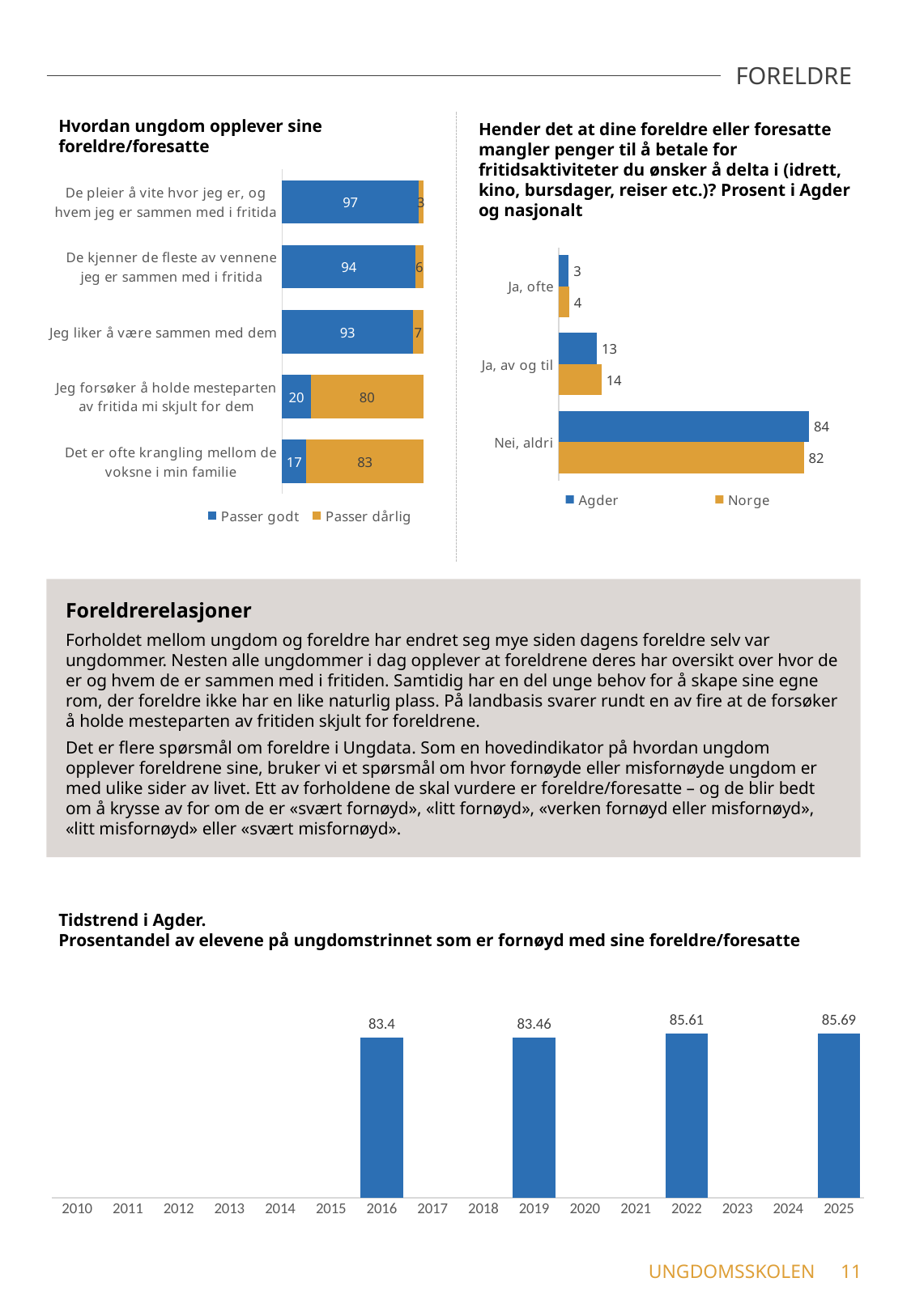
In the chart 'Tidstrend i Agder', which year has the highest value? 2025 In the chart 'Hvordan ungdom opplever sine foreldre/foresatte', how many statements are shown? 5 In the chart 'Hender det at dine foreldre eller foresatte mangler penger...', which is larger for 'Nei, aldri': Agder or Norge? Agder In the chart 'Hender det at dine foreldre eller foresatte mangler penger...', what is the difference between the Norge and Agder values for 'Ja, av og til'? 1 In the chart 'Hvordan ungdom opplever sine foreldre/foresatte', what is the total of the stacked bar for 'Jeg liker å være sammen med dem'? 100 In the chart 'Tidstrend i Agder', what is the value for 2022? 85.61 In the chart 'Hvordan ungdom opplever sine foreldre/foresatte', what is the 'Passer godt' value for 'De pleier å vite hvor jeg er, og hvem jeg er sammen med i fritida'? 97 In the chart 'Hvordan ungdom opplever sine foreldre/foresatte', what is the 'Passer dårlig' value for 'Jeg forsøker å holde mesteparten av fritida mi skjult for dem'? 80 In the chart 'Hvordan ungdom opplever sine foreldre/foresatte', which statement has the lowest 'Passer godt' value? Det er ofte krangling mellom de voksne i min familie In the chart 'Tidstrend i Agder', do the values rise or fall from 2016 to 2025? rise In the chart 'Hender det at dine foreldre eller foresatte mangler penger...', how many series does the legend list? 2 In the chart 'Hender det at dine foreldre eller foresatte mangler penger...', what is the Agder value for 'Nei, aldri'? 84